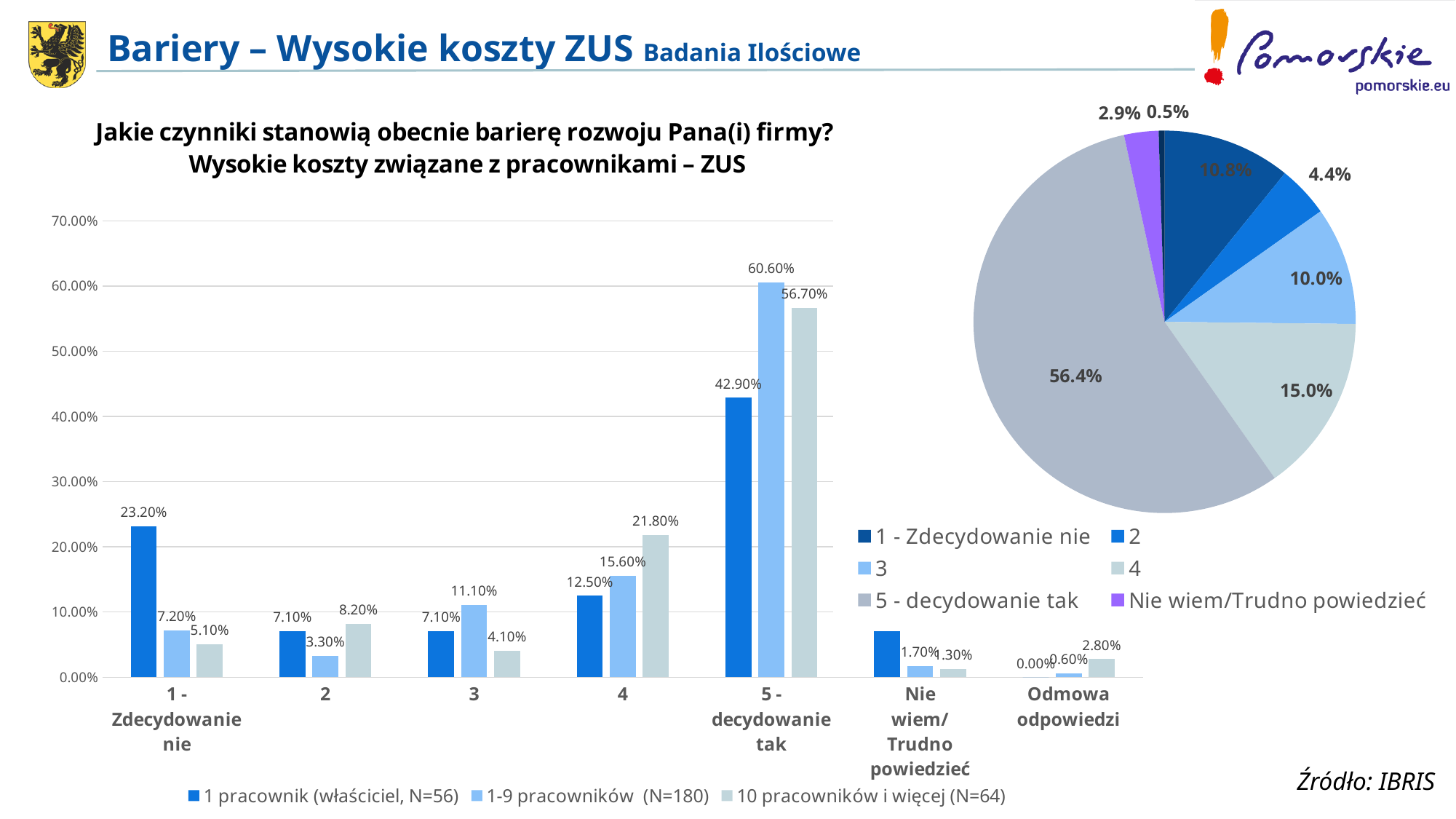
In the pie chart, what share does the slice '4' have? 15.0% In the bar chart, which category has the highest value for the series '1-9 pracowników (N=180)'? 5 - decydowanie tak In the pie chart, which slice is the largest? 5 - decydowanie tak In the bar chart, what is the value for '10 pracowników i więcej (N=64)' in category '4'? 21.80% In the bar chart, what is the difference between the '1-9 pracowników (N=180)' and '10 pracowników i więcej (N=64)' values in the category '5 - decydowanie tak'? 3.90% In the bar chart, which series has the larger value in the category '1 - Zdecydowanie nie': '1 pracownik (właściciel, N=56)' or '1-9 pracowników (N=180)'? 1 pracownik (właściciel, N=56) In the bar chart, what is the value for '1 pracownik (właściciel, N=56)' in the category '5 - decydowanie tak'? 42.90% In the bar chart, is the value for '1 pracownik (właściciel, N=56)' in the category 'Nie wiem/Trudno powiedzieć' greater or less than 10.00%? less In the pie chart, what share does the slice '1 - Zdecydowanie nie' have? 10.8% What kind of chart is the chart on the left side of the slide? bar chart How many categories are shown on the x axis of the bar chart? 7 How many series does the legend of the bar chart list? 3